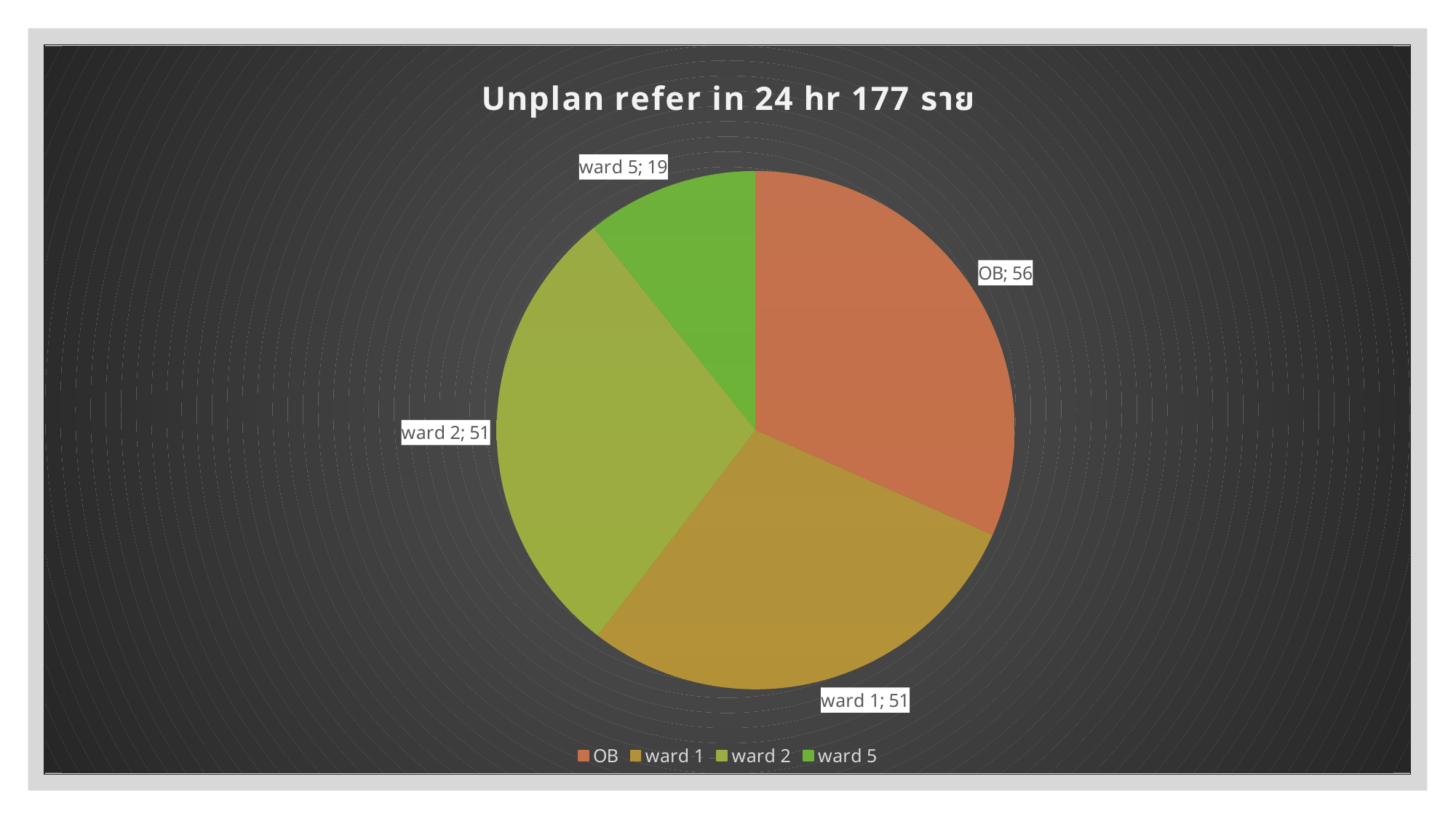
What is the value for ward 2 in the pie chart? 51 Which category has the largest slice of the pie? OB What kind of chart is shown on the slide? pie chart Which category has the smallest slice of the pie? ward 5 What is the value for OB in the pie chart? 56 What is the value for ward 5 in the pie chart? 19 What is the title of the chart? Unplan refer in 24 hr 177 ราย Which is larger, the value for OB or the value for ward 5? OB What is the difference between the values for OB and ward 1? 5 What is the value for ward 1 in the pie chart? 51 What is the difference between the values for OB and ward 5? 37 How many categories are shown in the pie chart? 4